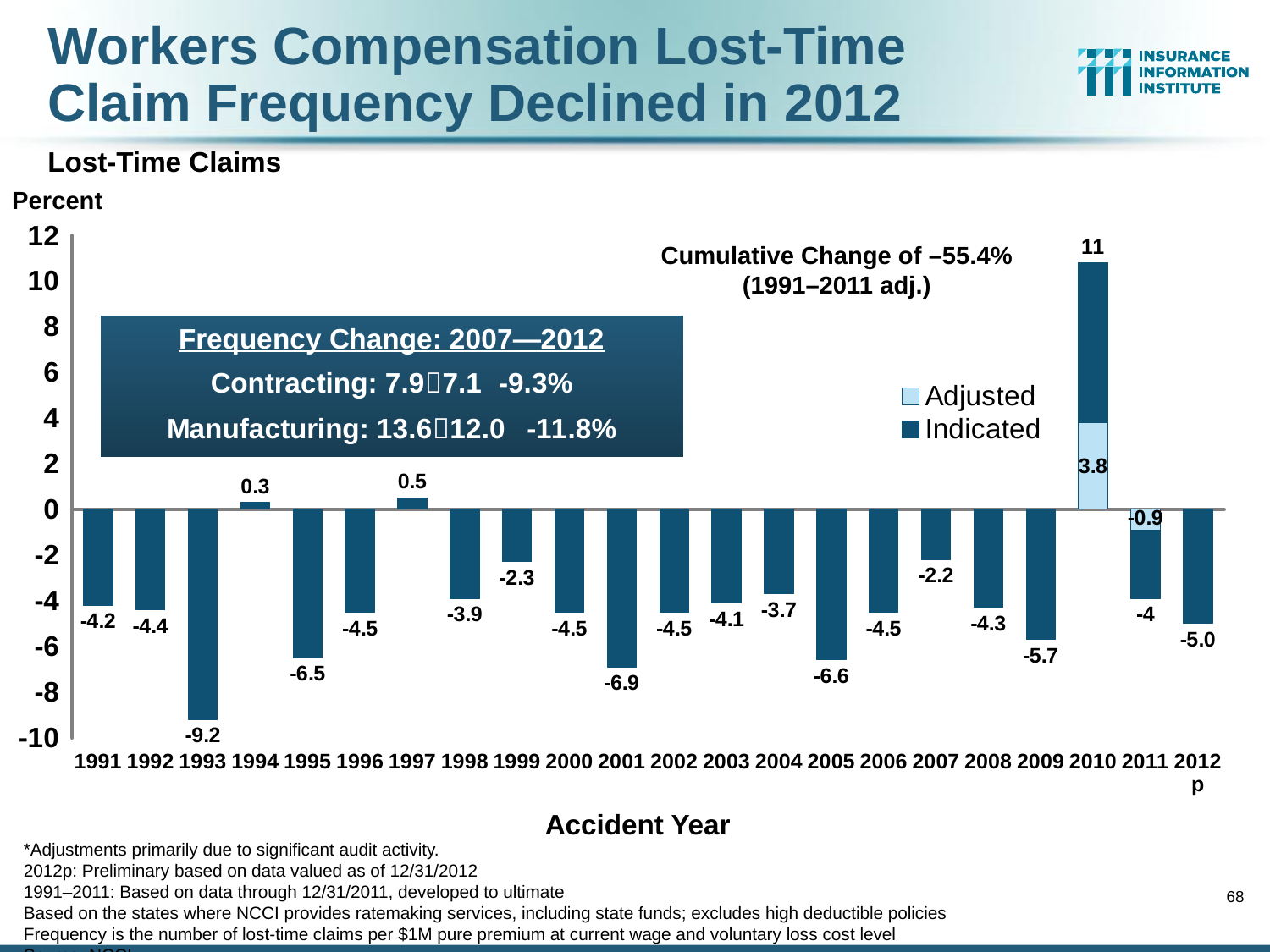
Which accident year has the lowest value? 1993 What is the difference between the values for 2001 and 2005? 0.3 What is the value for 2012p? -5.0 How many series does the legend list? 2 How many accident years are shown on the x axis? 22 What is the Adjusted value shown for 2010? 3.8 What is the value for 2001? -6.9 What is the title of the x axis? Accident Year Which is larger, the value for 1995 or the value for 2009? 2009 What is the value for 1993? -9.2 Which accident year has the highest value? 2010 What kind of chart is shown? Bar chart